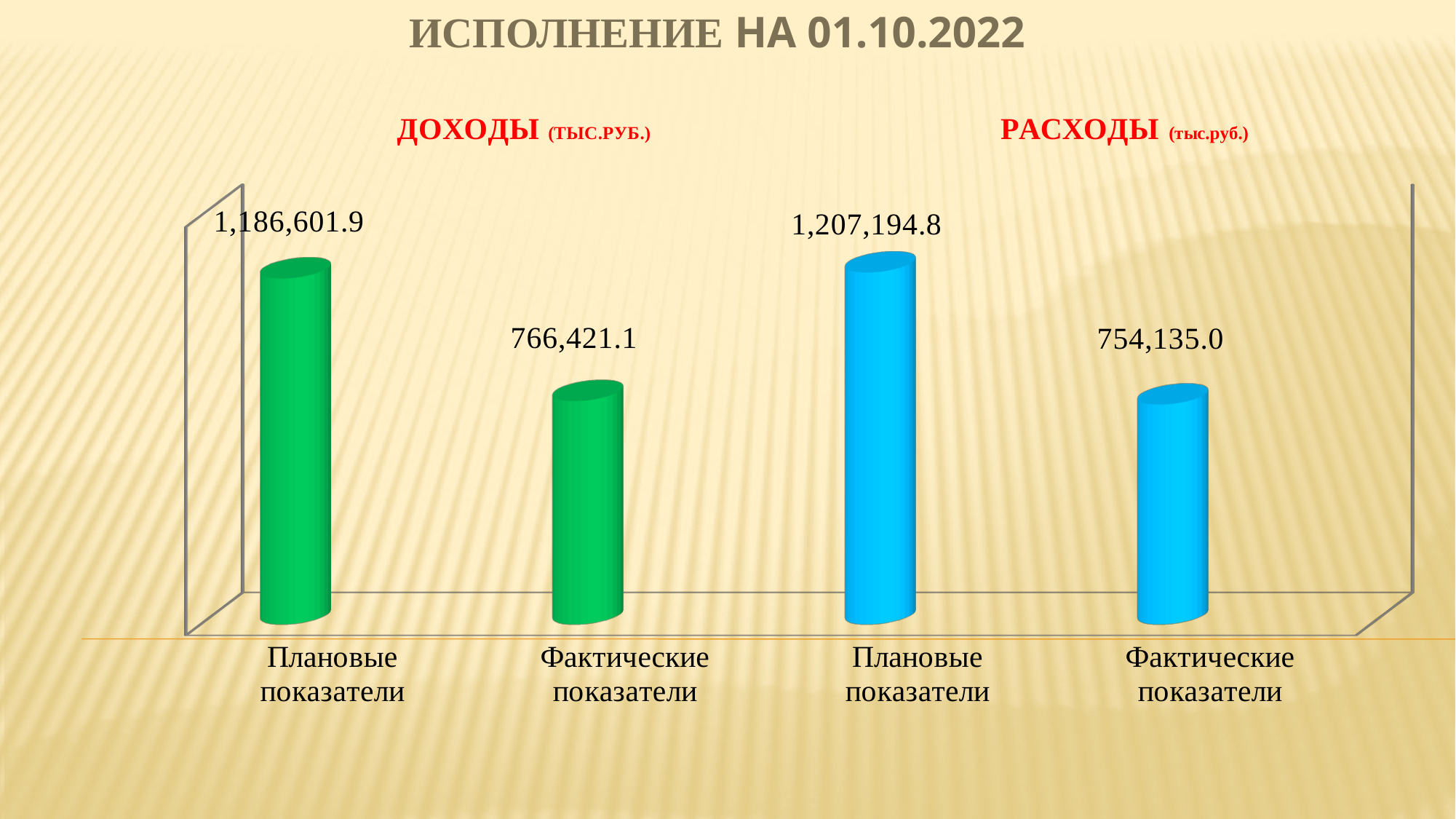
What is the title of the slide? ИСПОЛНЕНИЕ НА 01.10.2022 What is the difference between the planned and actual values for РАСХОДЫ? 453,059.8 What is the difference between the planned and actual values for ДОХОДЫ? 420,180.8 What type of chart is shown on the slide? Bar chart How many bars are plotted on the chart? 4 What is the actual (Фактические показатели) value for РАСХОДЫ? 754,135.0 What is the actual (Фактические показатели) value for ДОХОДЫ? 766,421.1 Which bar has the lowest value on the chart? Фактические показатели (РАСХОДЫ) What is the planned (Плановые показатели) value for РАСХОДЫ? 1,207,194.8 What is the planned (Плановые показатели) value for ДОХОДЫ? 1,186,601.9 Which is larger: the planned value for ДОХОДЫ or the planned value for РАСХОДЫ? Planned value for РАСХОДЫ Which bar has the highest value on the chart? Плановые показатели (РАСХОДЫ)